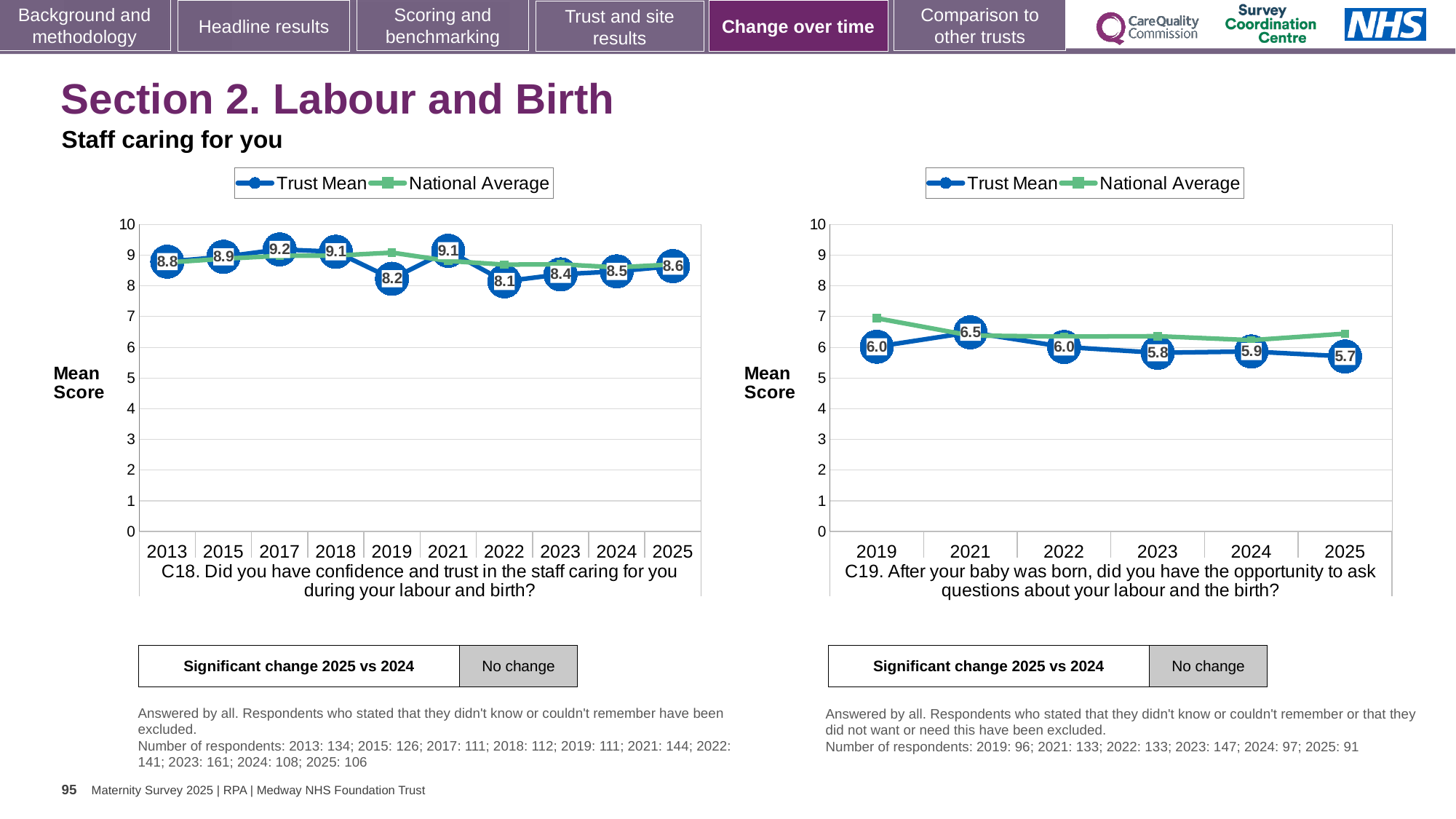
In the C18 chart on the left, which year has the highest Trust Mean score? 2017 In the C18 chart on the left, how many years are plotted on the x axis? 10 In the C19 chart on the right, is the Trust Mean score for 2023 or 2024 larger? 2024 In the C18 chart on the left, what is the Trust Mean score for 2025? 8.6 In the C18 chart on the left, what is the difference between the Trust Mean scores for 2021 and 2022? 1.0 In the C18 chart on the left, which year has the lowest Trust Mean score? 2022 In the C19 chart on the right, which year has the lowest Trust Mean score? 2025 How many series does the legend of the C19 chart on the right list? 2 In the C19 chart on the right, is the National Average value for 2019 greater or less than 6? greater What kind of chart is the C18 chart on the left? Line chart In the C18 chart on the left, what is the Trust Mean score for 2017? 9.2 In the C19 chart on the right, what is the Trust Mean score for 2021? 6.5